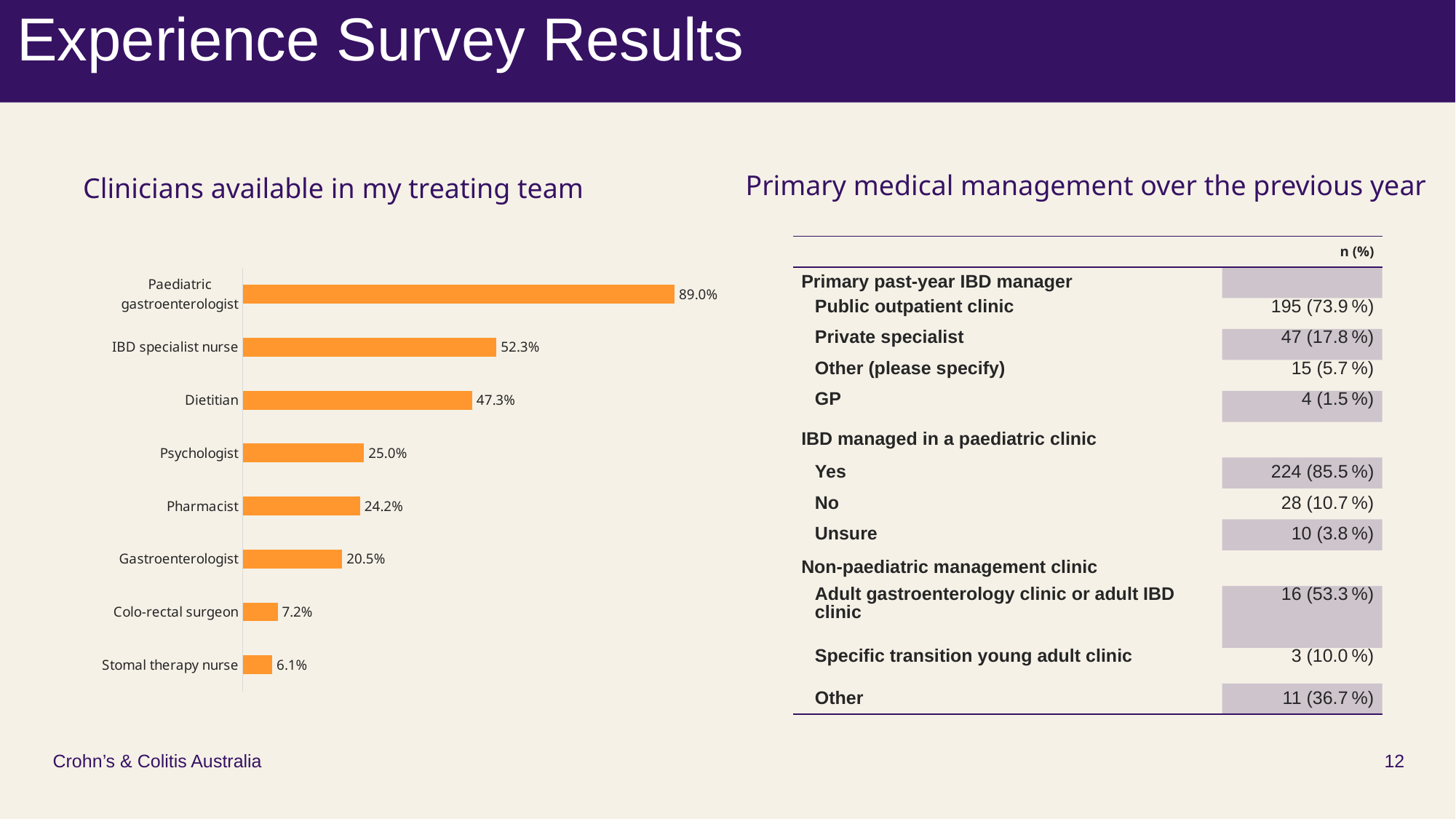
Which clinician has the lowest value in the bar chart? Stomal therapy nurse In the bar chart, what percentage is shown for Dietitian? 47.3% In the bar chart, what is the value for Colo-rectal surgeon? 7.2% What kind of chart is shown under the title "Clinicians available in my treating team"? Bar chart In the bar chart, what is the difference between the values for Paediatric gastroenterologist and IBD specialist nurse? 36.7 percentage points In the bar chart, which is larger: the value for Psychologist or the value for Pharmacist? Psychologist In the bar chart, what percentage is shown for Paediatric gastroenterologist? 89.0% What colour are the bars in the bar chart? Orange How many clinician categories are shown in the bar chart? 8 Which clinician has the highest value in the bar chart? Paediatric gastroenterologist In the bar chart, do the values increase or decrease going from the top bar to the bottom bar? Decrease In the bar chart, what is the value for IBD specialist nurse? 52.3%